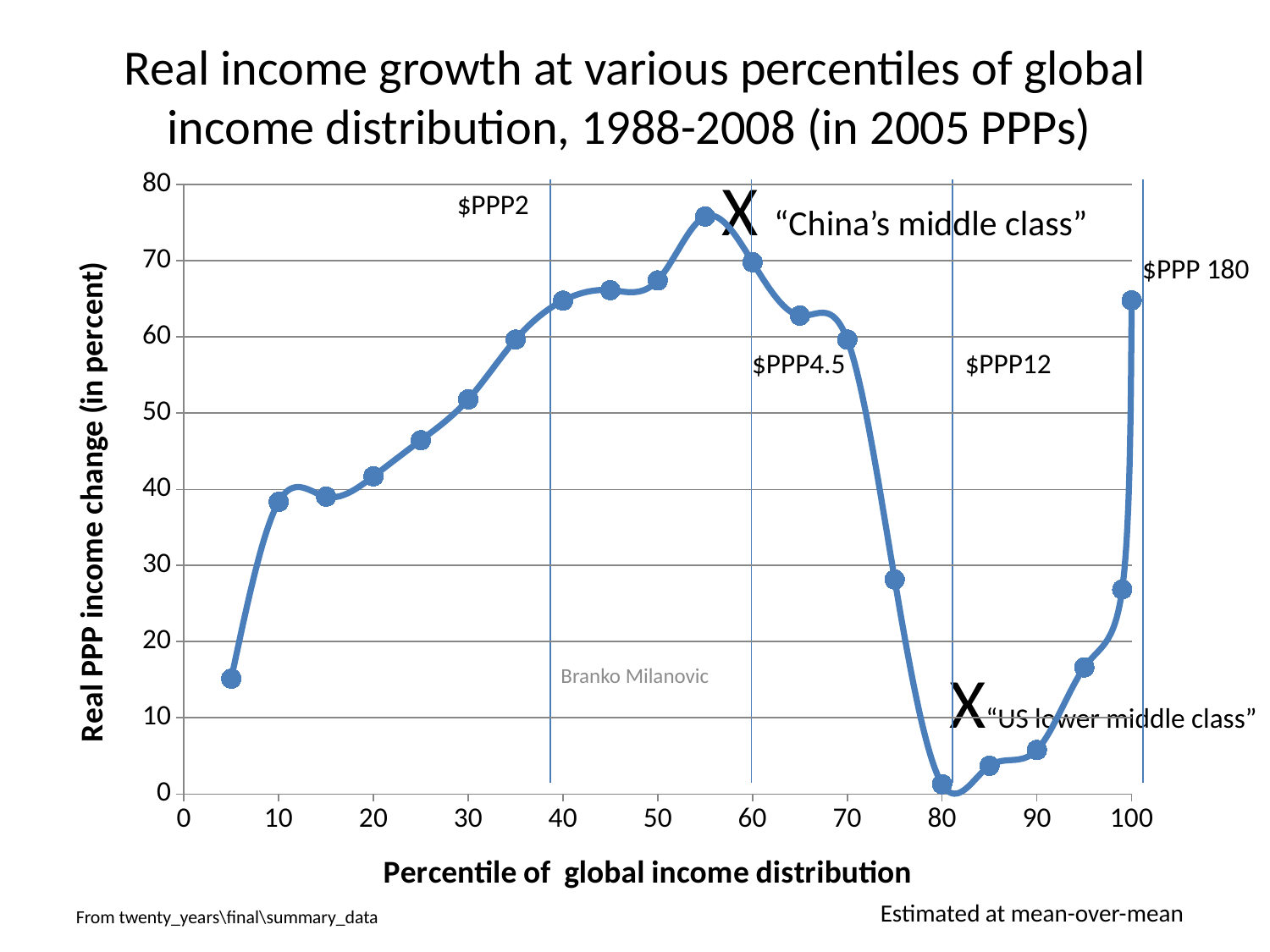
What is the title of the vertical axis? Real PPP income change (in percent) Does the real PPP income change rise or fall as the percentile increases from 5 to 55? rise Is the real PPP income change at the 80th percentile greater or less than 10? less Is the real PPP income change at the 100th percentile greater or less than 60? greater Is the real PPP income change at the 5th percentile greater or less than 20? less Which has the larger real PPP income change, the 85th percentile or the 95th percentile? 95th percentile At which percentile of the global income distribution is the real PPP income change lowest? 80 Which has the larger real PPP income change, the 55th percentile or the 60th percentile? 55th percentile At which percentile of the global income distribution is the real PPP income change highest? 55 What kind of chart is shown on the slide? line chart